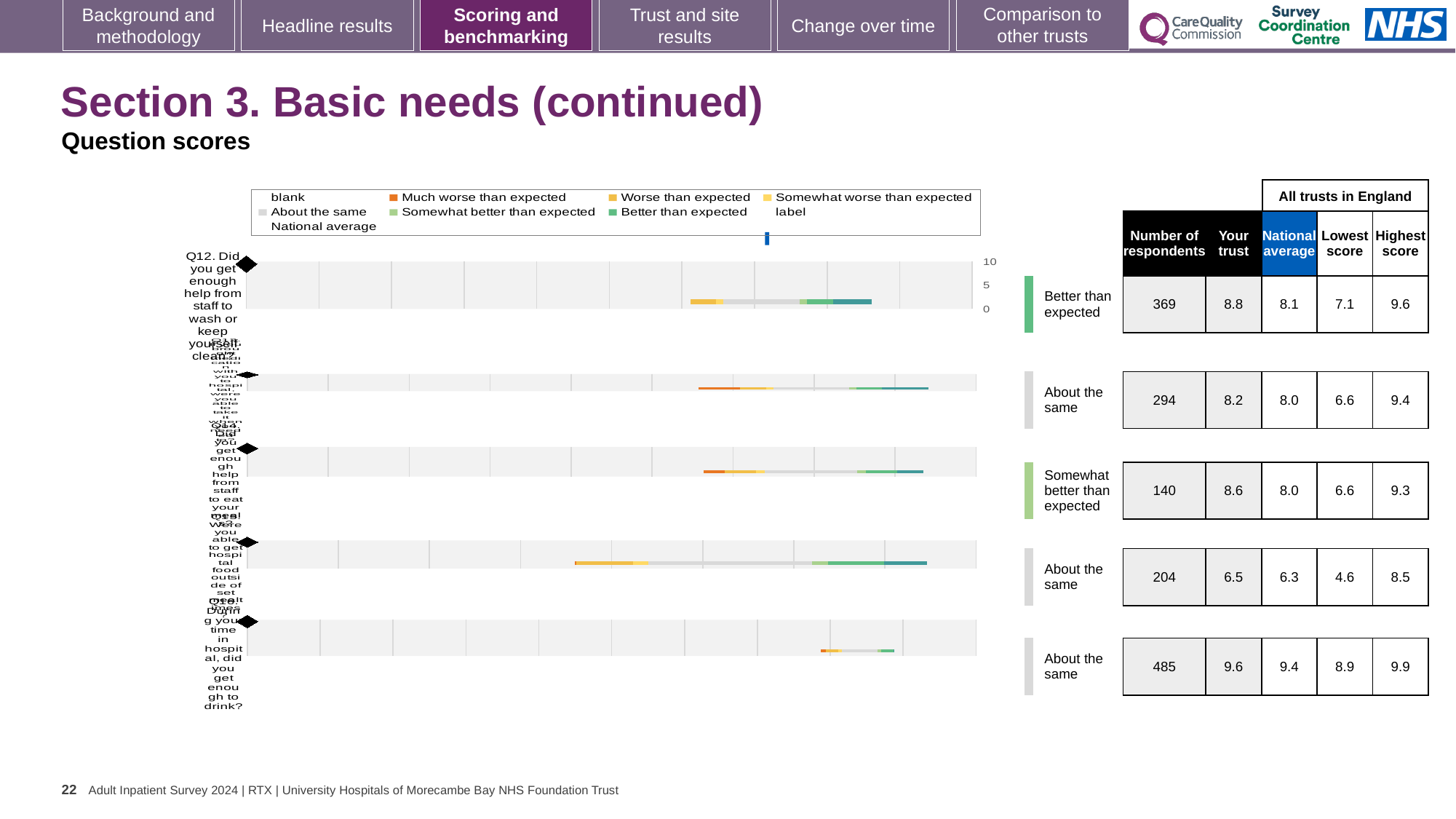
What kind of chart is used to show the question scores on this slide? bar chart For the third row (Q14, help from staff to eat your meals), which is larger: the 'Your trust' score or the national average? Your trust (8.6) Which row has the lowest 'Your trust' score? Q15 (hospital food outside of set meal times), 6.5 What is the highest score among all trusts in England for the last row (Q16)? 9.9 Which row is rated 'Better than expected'? Q12 (the first row) What is the number of respondents for the first row (Q12, help from staff to wash or keep yourself clean)? 369 What is the 'Your trust' score for the first row (Q12)? 8.8 For the first row (Q12), what is the difference between the 'Your trust' score and the national average? 0.7 Which row has the highest 'Your trust' score? Q16 (enough to drink), 9.6 How many rows are rated 'About the same'? 3 How many question rows are plotted in the chart? 5 What colour does the legend use for 'Much worse than expected'? orange